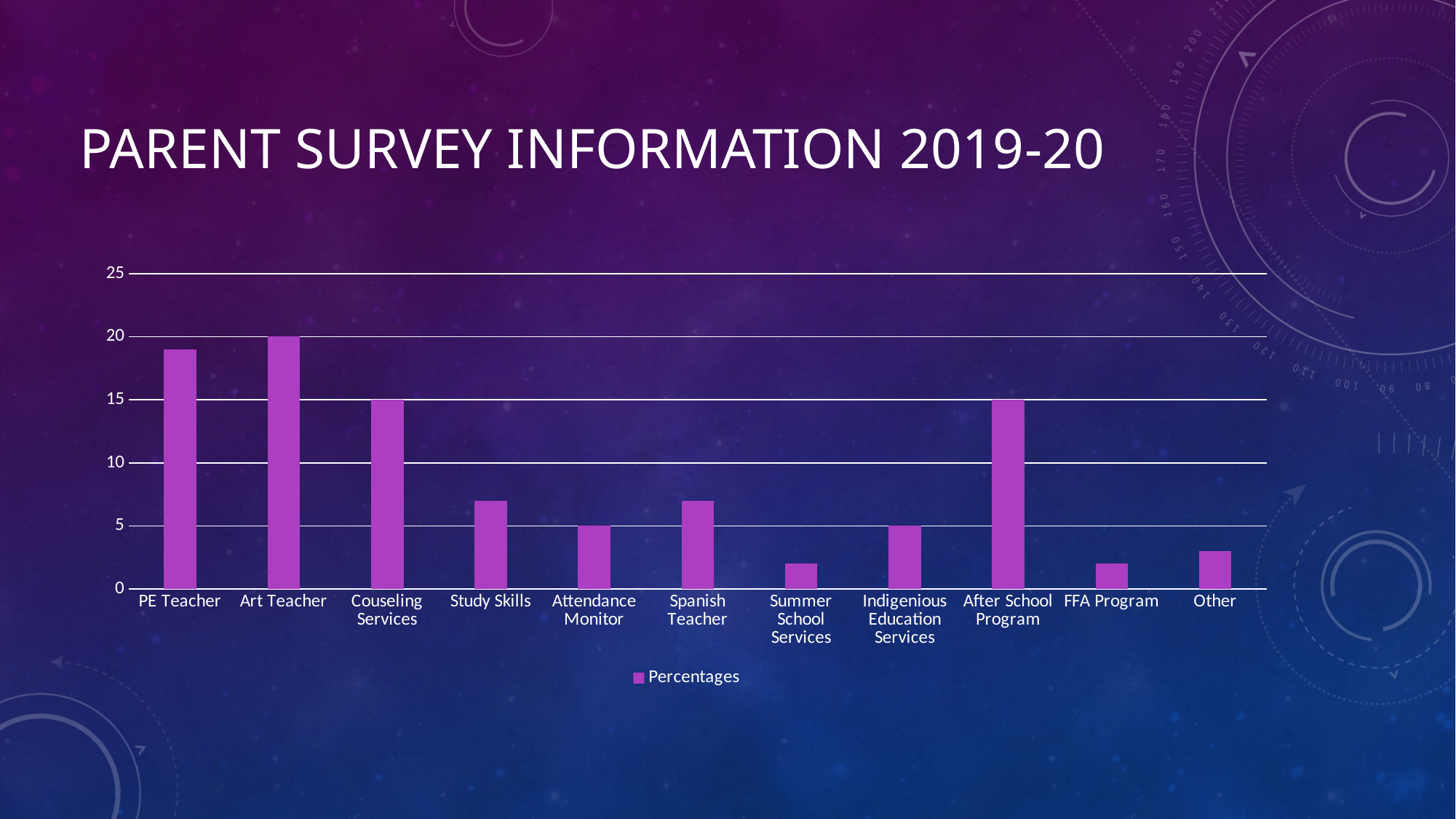
What is the value for Attendance Monitor? 5 Which category has the highest value? Art Teacher What is the value for Art Teacher? 20 What is the value for Couseling Services? 15 How many series does the legend list? 1 What kind of chart is shown on the slide? bar chart Which is larger, the value for Couseling Services or the value for Study Skills? Couseling Services Is the value for Other greater or less than 5? less How many categories are shown on the x axis? 11 What is the value for After School Program? 15 What is the difference between the values for Art Teacher and Couseling Services? 5 Is the value for PE Teacher greater or less than 15? greater